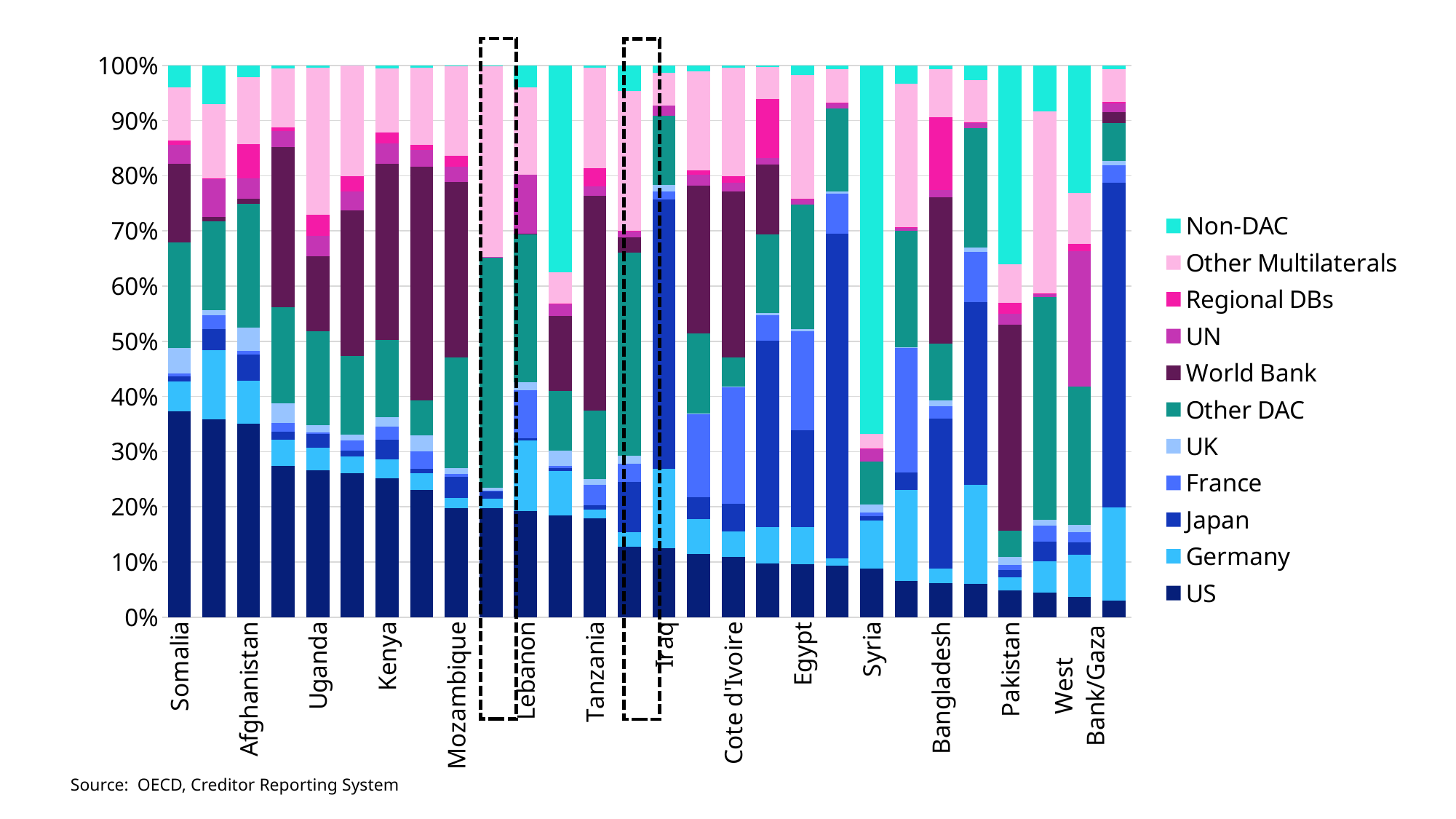
What kind of chart is shown on the slide? Stacked bar chart How many country labels are shown on the x axis? 14 How many series does the legend list? 11 What source is cited below the chart? OECD, Creditor Reporting System Which has the larger Japan share, Egypt or Somalia? Egypt Which series is plotted at the bottom of each bar? US Does the US share rise or fall moving from Somalia on the left to West Bank/Gaza on the right? Fall Is the Japan share for Egypt greater or less than 30%? less Is the US share for Somalia greater or less than 30%? greater Is the US share for West Bank/Gaza greater or less than 10%? less